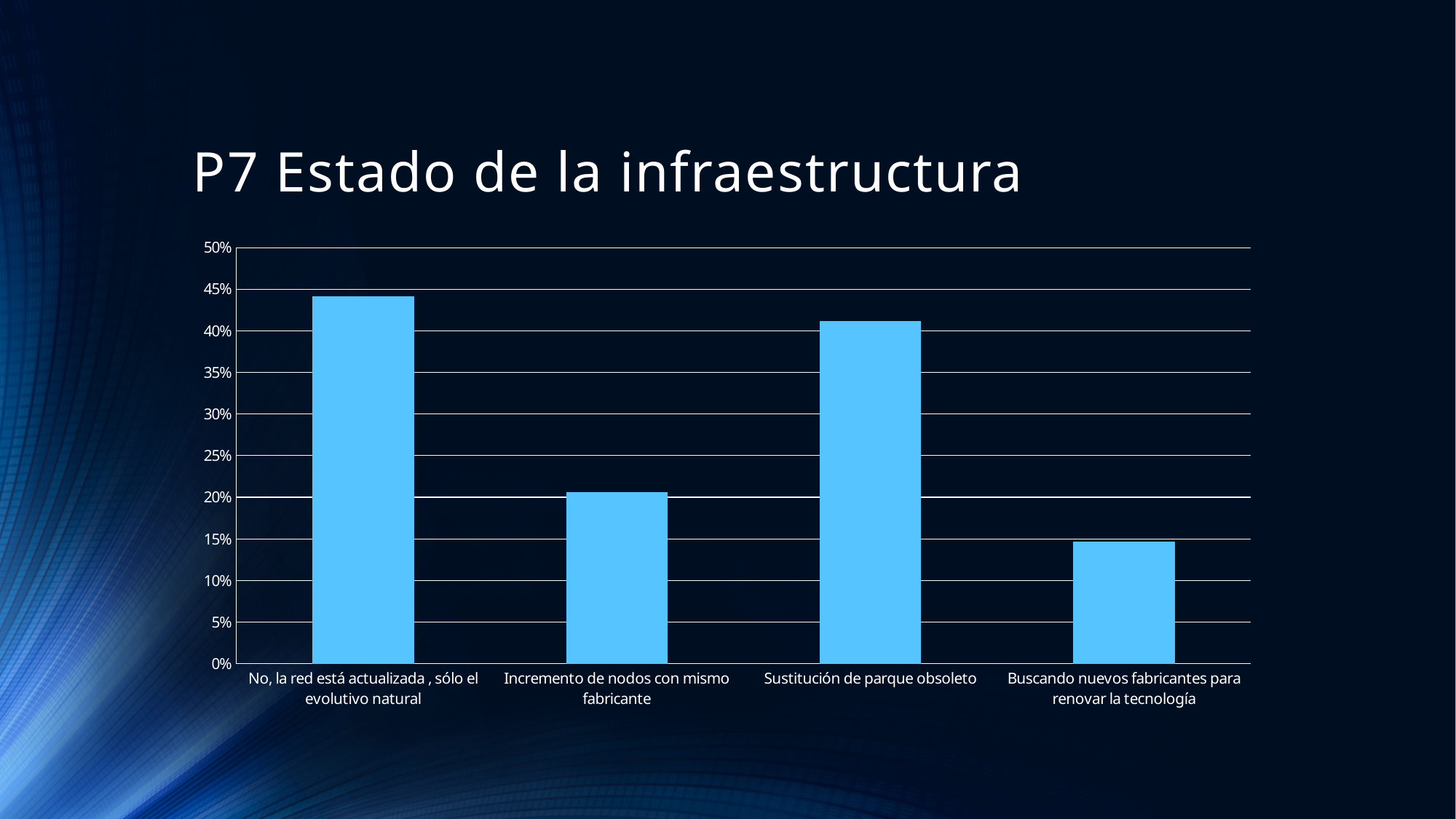
Is the value for "Buscando nuevos fabricantes para renovar la tecnología" greater or less than 10%? greater Is the value for "Sustitución de parque obsoleto" greater or less than 45%? less Is the value for "No, la red está actualizada , sólo el evolutivo natural" greater or less than 40%? greater What kind of chart is shown on the slide? bar chart Which is larger: the value for "Incremento de nodos con mismo fabricante" or for "Buscando nuevos fabricantes para renovar la tecnología"? Incremento de nodos con mismo fabricante Which is larger: the value for "No, la red está actualizada , sólo el evolutivo natural" or for "Sustitución de parque obsoleto"? No, la red está actualizada , sólo el evolutivo natural Which category has the highest value in the chart? No, la red está actualizada , sólo el evolutivo natural What is the title of the slide containing the chart? P7 Estado de la infraestructura How many categories are shown on the x axis of the chart? 4 Which category has the lowest value in the chart? Buscando nuevos fabricantes para renovar la tecnología